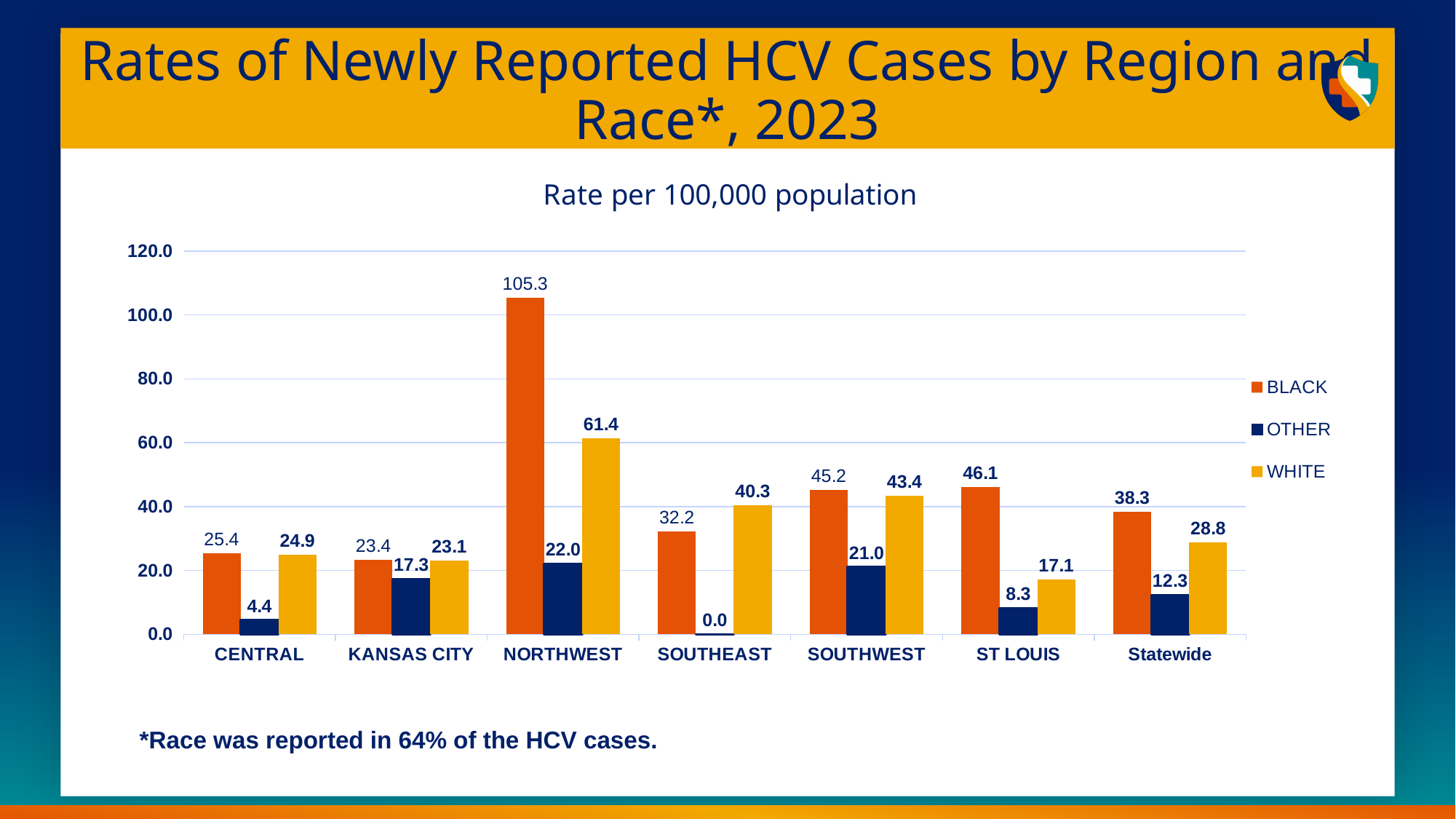
How many categories are shown on the x axis? 7 Which region has the highest rate for the BLACK series? NORTHWEST What is the Statewide rate for WHITE? 28.8 What kind of chart is shown on the slide? bar chart Which is larger in ST LOUIS, the BLACK rate or the WHITE rate? BLACK What is the rate for BLACK in the NORTHWEST region? 105.3 Is the BLACK rate in the NORTHWEST region greater or less than 100.0? greater What is the difference between the BLACK and WHITE rates in the NORTHWEST region? 43.9 What is the axis title shown above the chart? Rate per 100,000 population What is the rate for OTHER in the SOUTHEAST region? 0.0 Which category has the lowest rate for the OTHER series? SOUTHEAST How many series does the legend list? 3